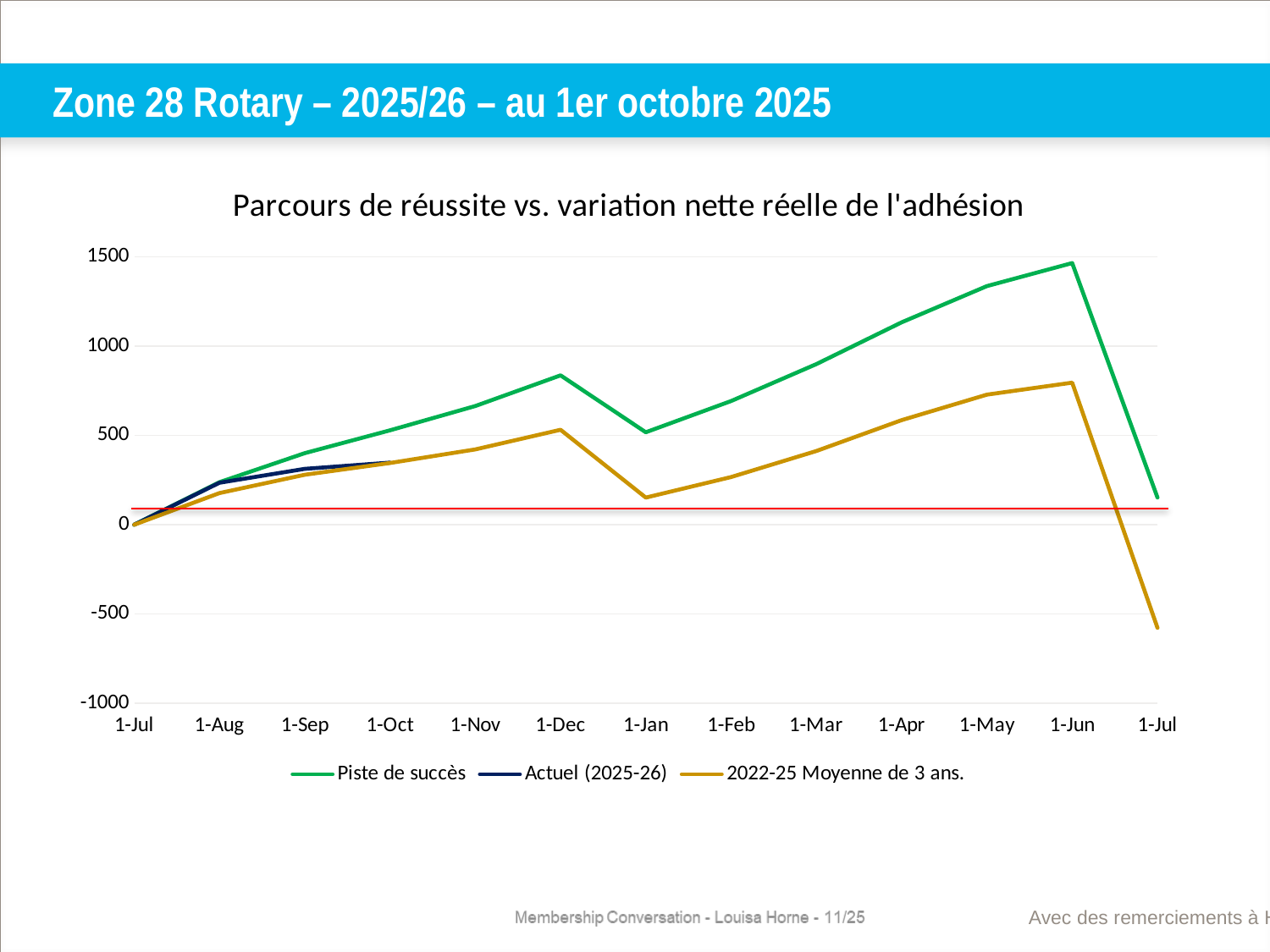
At which date does the Piste de succès series reach its highest value? 1-Jun At 1-Dec, which is larger: Piste de succès or 2022-25 Moyenne de 3 ans.? Piste de succès How many series does the legend list? 3 Which series is drawn in green? Piste de succès How many dates are labelled along the x axis? 13 What kind of chart is shown on the slide? line chart Is the value for 2022-25 Moyenne de 3 ans. at the final 1-Jul greater or less than -500? less Is the value for Piste de succès at 1-Dec greater or less than 500? greater At which date does the 2022-25 Moyenne de 3 ans. series reach its lowest value? 1-Jul (the final point) What is the title of the chart? Parcours de réussite vs. variation nette réelle de l'adhésion Is the value for Piste de succès at 1-Jun greater or less than 1000? greater Does the Piste de succès series rise or fall between 1-Jan and 1-Jun? rise